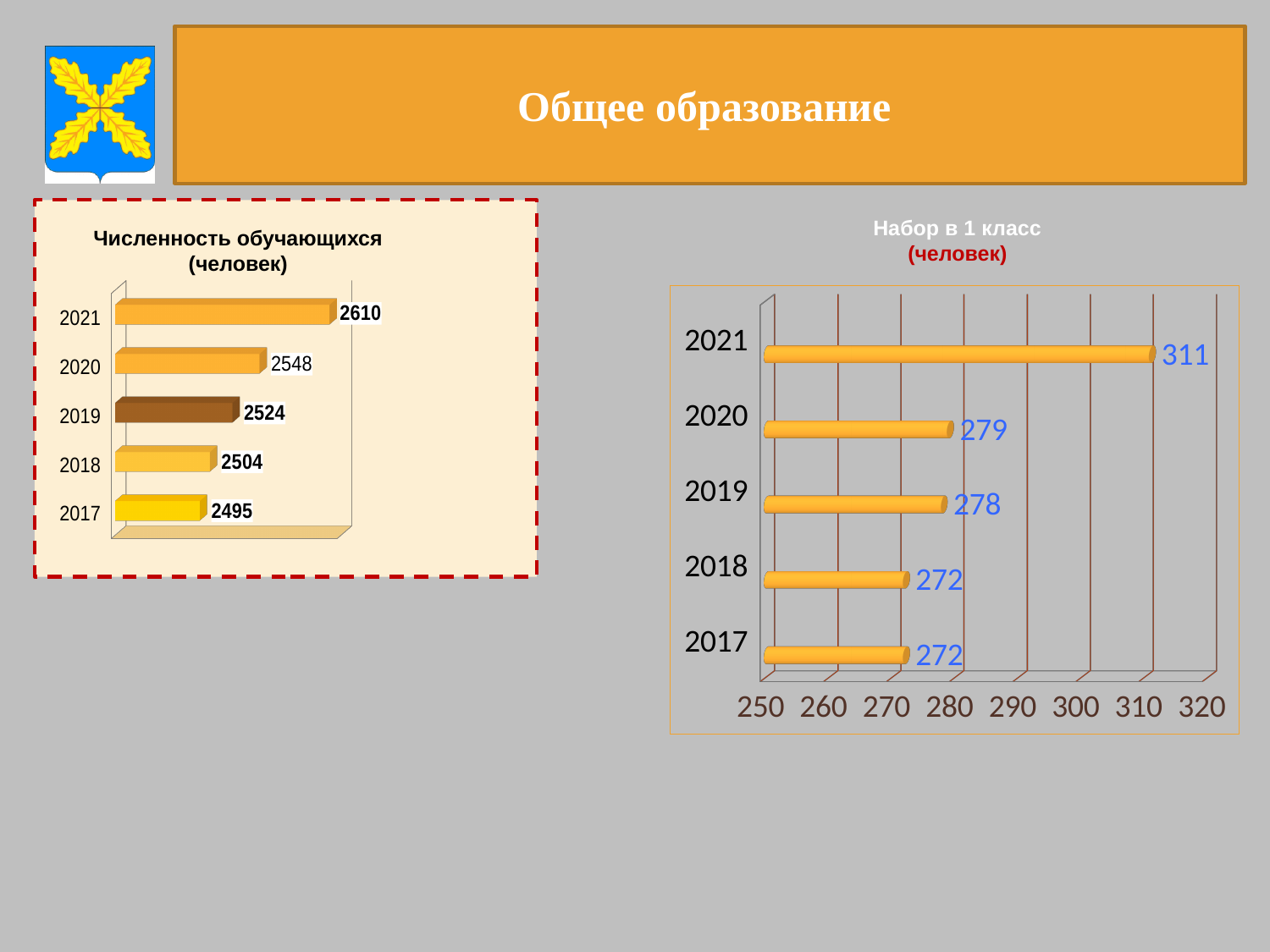
In the chart titled 'Набор в 1 класс (человек)', what is the difference between the values for 2021 and 2020? 32 In the chart titled 'Численность обучающихся (человек)', what is the difference between the values for 2021 and 2020? 62 In the chart titled 'Численность обучающихся (человек)', how many years are shown? 5 In the chart titled 'Численность обучающихся (человек)', what is the value for 2021? 2610 In the chart titled 'Набор в 1 класс (человек)', what is the value for 2021? 311 In the chart titled 'Набор в 1 класс (человек)', what is the value for 2019? 278 In the chart titled 'Численность обучающихся (человек)', which year has the lowest value? 2017 In the chart titled 'Численность обучающихся (человек)', what is the value for 2017? 2495 In the chart titled 'Численность обучающихся (человек)', do the values rise or fall from 2017 to 2021? rise What kind of chart is the chart titled 'Набор в 1 класс (человек)'? bar chart In the chart titled 'Набор в 1 класс (человек)', is the value for 2020 greater or less than 270? greater In the chart titled 'Набор в 1 класс (человек)', which year has the highest value? 2021